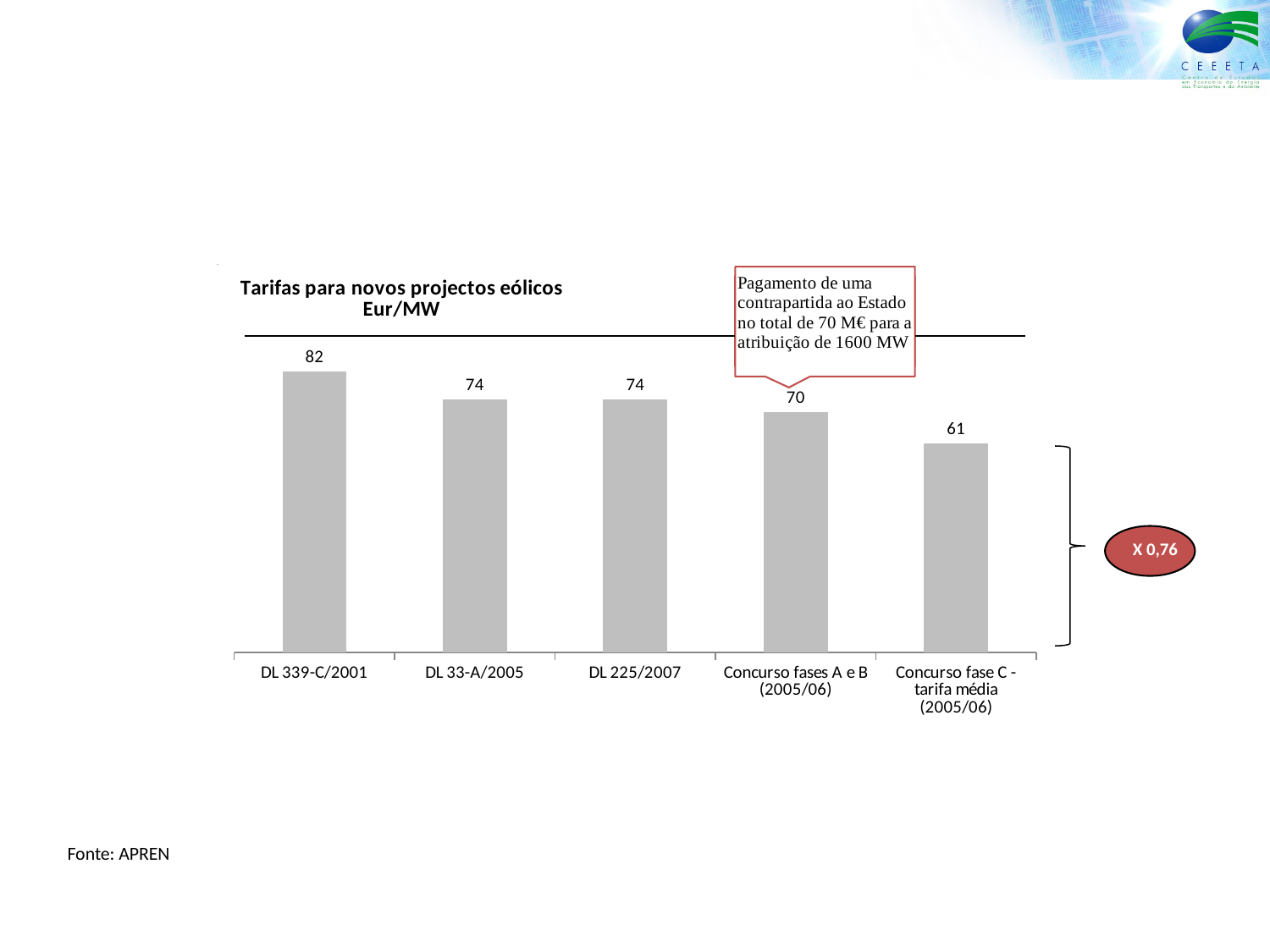
What is the tariff value for Concurso fase C - tarifa média (2005/06)? 61 How many categories are shown in the chart? 5 Which is larger, the tariff for DL 33-A/2005 or the tariff for Concurso fase C - tarifa média (2005/06)? DL 33-A/2005 What is the difference between the tariff for DL 225/2007 and the tariff for Concurso fases A e B (2005/06)? 4 What is the tariff value for DL 339-C/2001? 82 Which category has the highest tariff? DL 339-C/2001 What is the difference between the tariff for DL 339-C/2001 and the tariff for Concurso fase C - tarifa média (2005/06)? 21 What is the tariff value for Concurso fases A e B (2005/06)? 70 What kind of chart is shown on the slide? Bar chart Which category has the lowest tariff? Concurso fase C - tarifa média (2005/06) What is the title of the chart? Tarifas para novos projectos eólicos Eur/MW What is the tariff value for DL 33-A/2005? 74